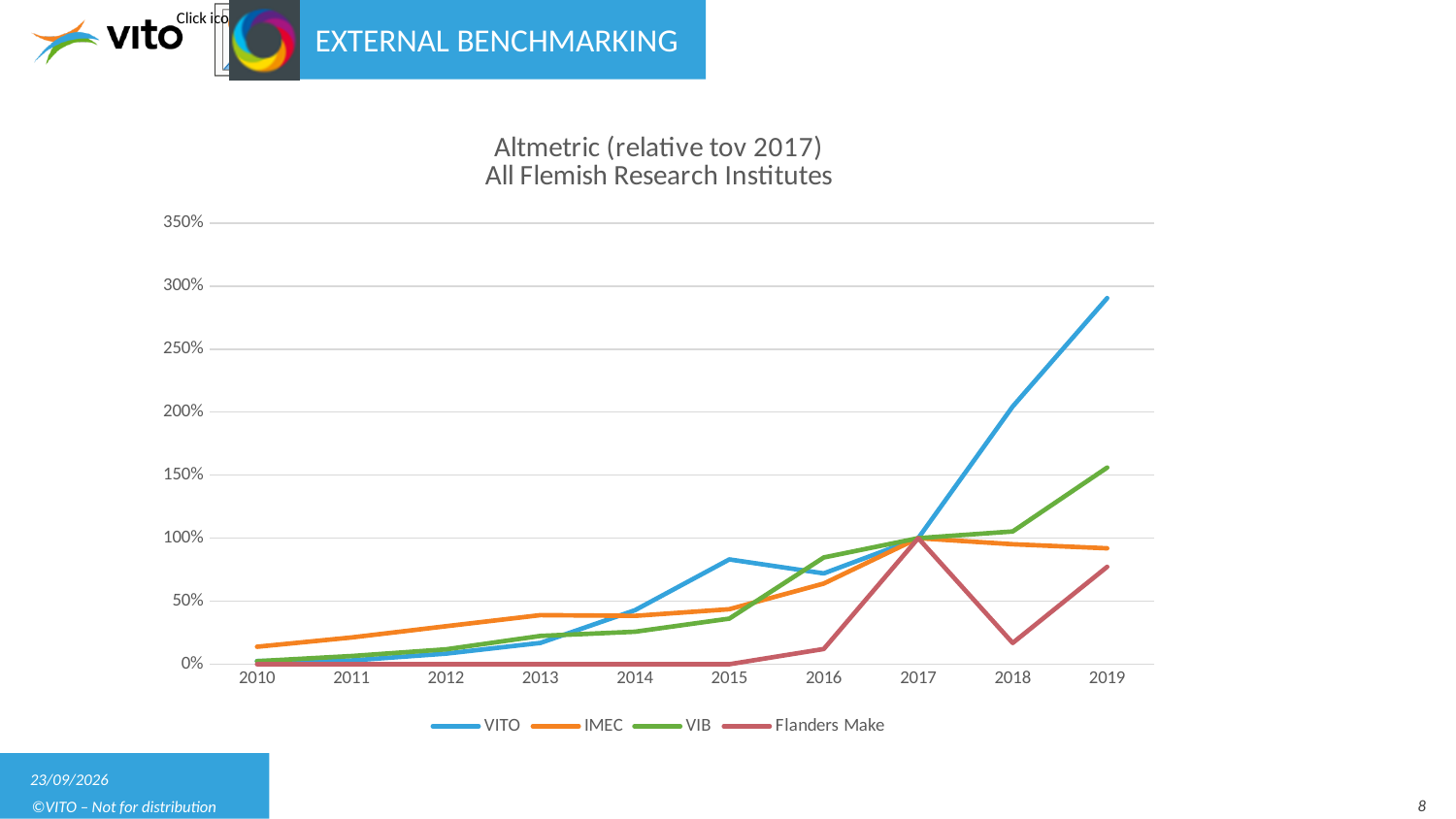
How many series does the legend list? 4 How many years are shown along the x axis? 10 Is the value for Flanders Make in 2018 greater or less than 50%? less Which series has the lowest value in 2019? Flanders Make What is the value for VITO in 2017? 100% Is the value for IMEC in 2019 greater or less than 100%? less What is the title of the chart? Altmetric (relative tov 2017) All Flemish Research Institutes Does the VITO line rise or fall from 2017 to 2019? rise Is the value for VITO in 2019 greater or less than 250%? greater What kind of chart is shown on the slide? line chart Which series has the highest value in 2019? VITO Which is larger in 2019, the value for VIB or the value for IMEC? VIB